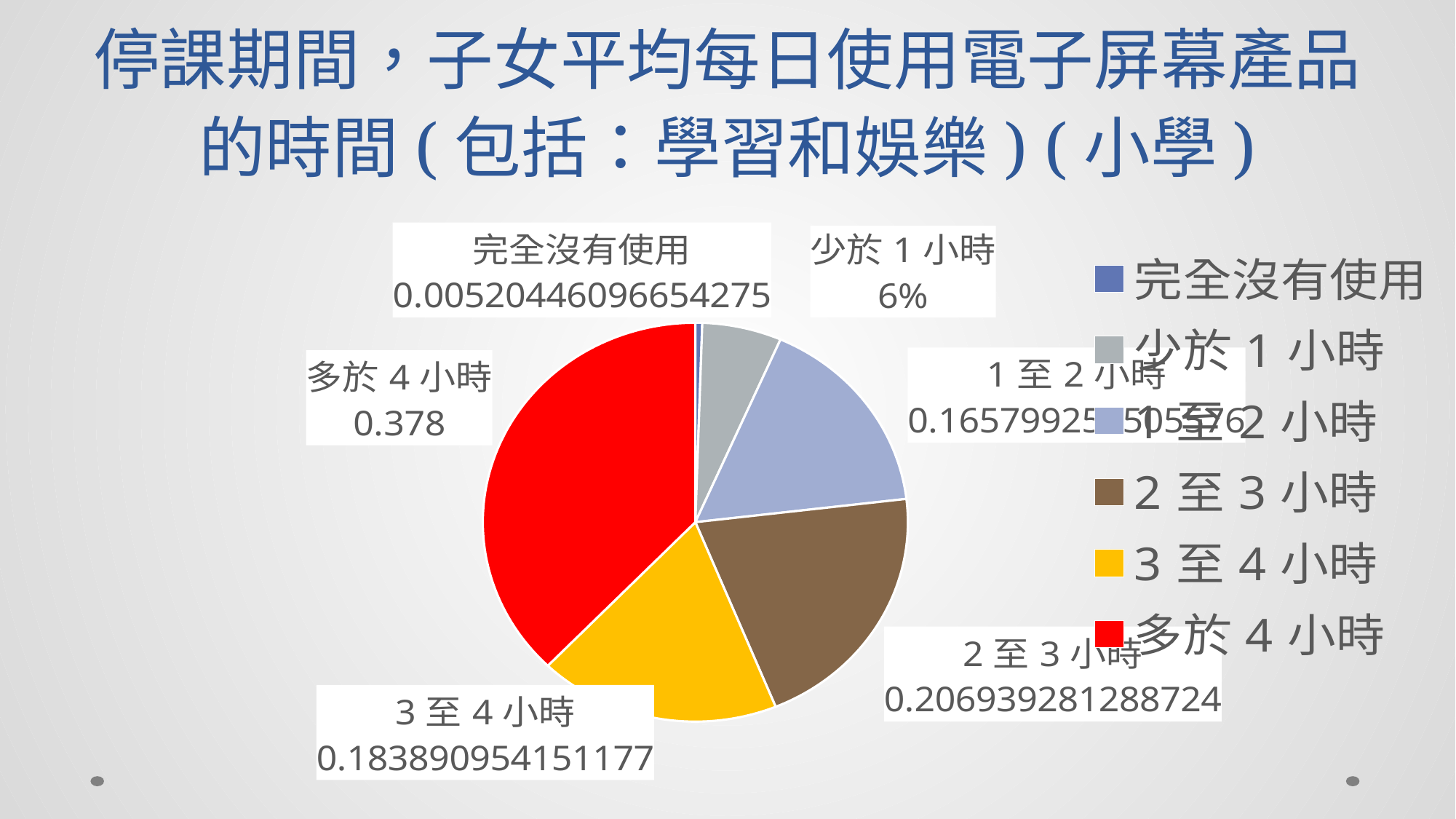
Which category has the smallest slice of the pie? 完全沒有使用 What is the value shown for 3 至 4 小時? 0.183890954151177 How many categories does the pie chart have? 6 Which is larger, the value for 2 至 3 小時 or the value for 3 至 4 小時? 2 至 3 小時 Which category has the largest slice of the pie? 多於 4 小時 What is the value shown for 多於 4 小時? 0.378 What kind of chart is shown on the slide? pie chart How many entries does the legend list? 6 What colour is the slice for 多於 4 小時? red What percentage is shown for 少於 1 小時? 6% What is the value shown for 完全沒有使用? 0.00520446096654275 What is the value shown for 2 至 3 小時? 0.206939281288724